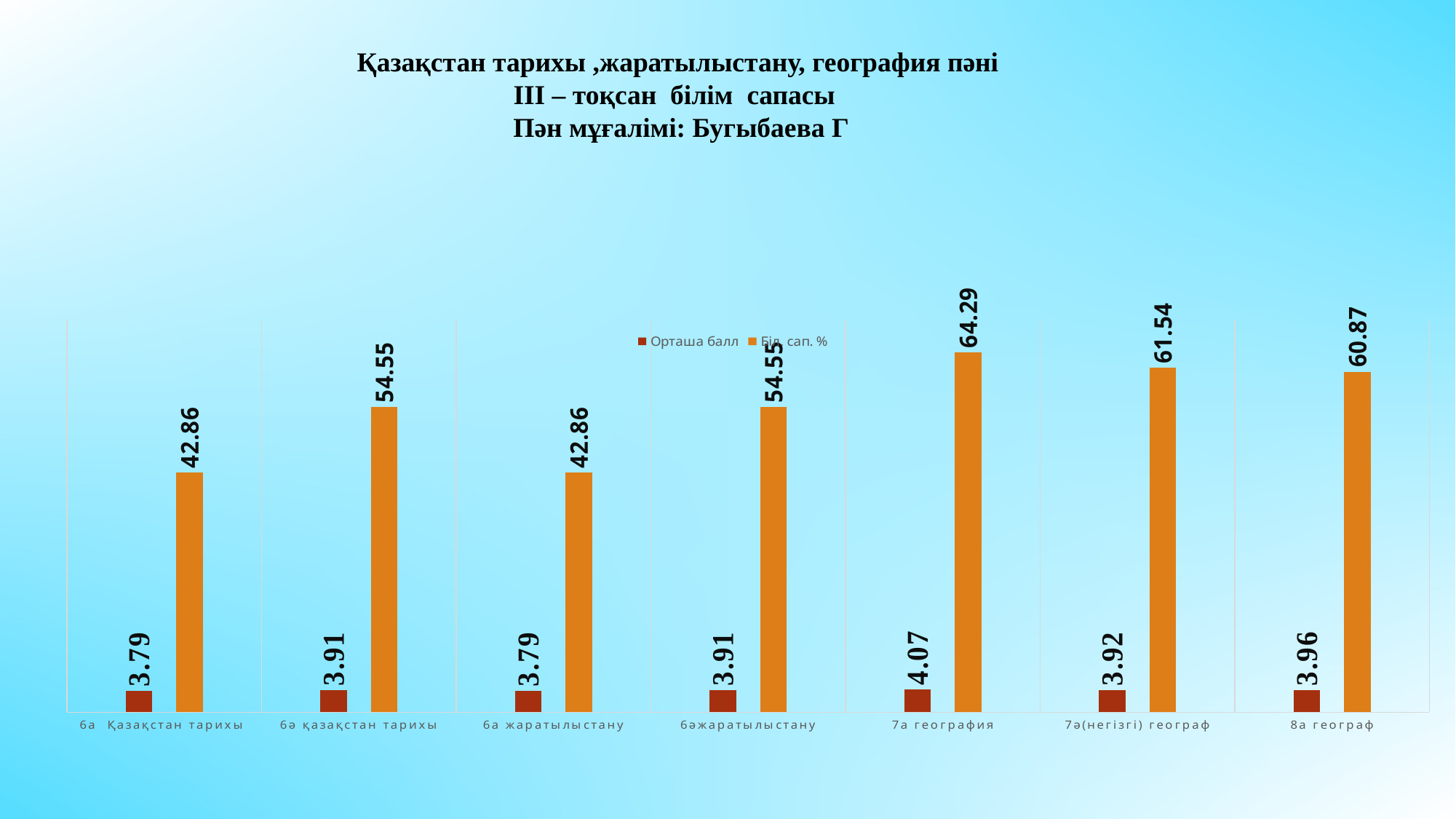
What is the Орташа балл value for 6а жаратылыстану? 3.79 Which series in the legend is shown in orange? Біл. сап. % How many series does the chart's legend list? 2 What is the Біл. сап. % value for 8а географ? 60.87 Which category has the highest Орташа балл value? 7а география What is the difference between the Біл. сап. % values for 7а география and 6а Қазақстан тарихы? 21.43 What is the Орташа балл value for 7а география? 4.07 Which category has the highest Біл. сап. % value? 7а география Which is larger, the Біл. сап. % value for 7ә(негізгі) географ or for 8а географ? 7ә(негізгі) географ What is the Біл. сап. % value for 6ә қазақстан тарихы? 54.55 How many categories are shown on the x axis of the chart? 7 What type of chart is shown on the slide? bar chart